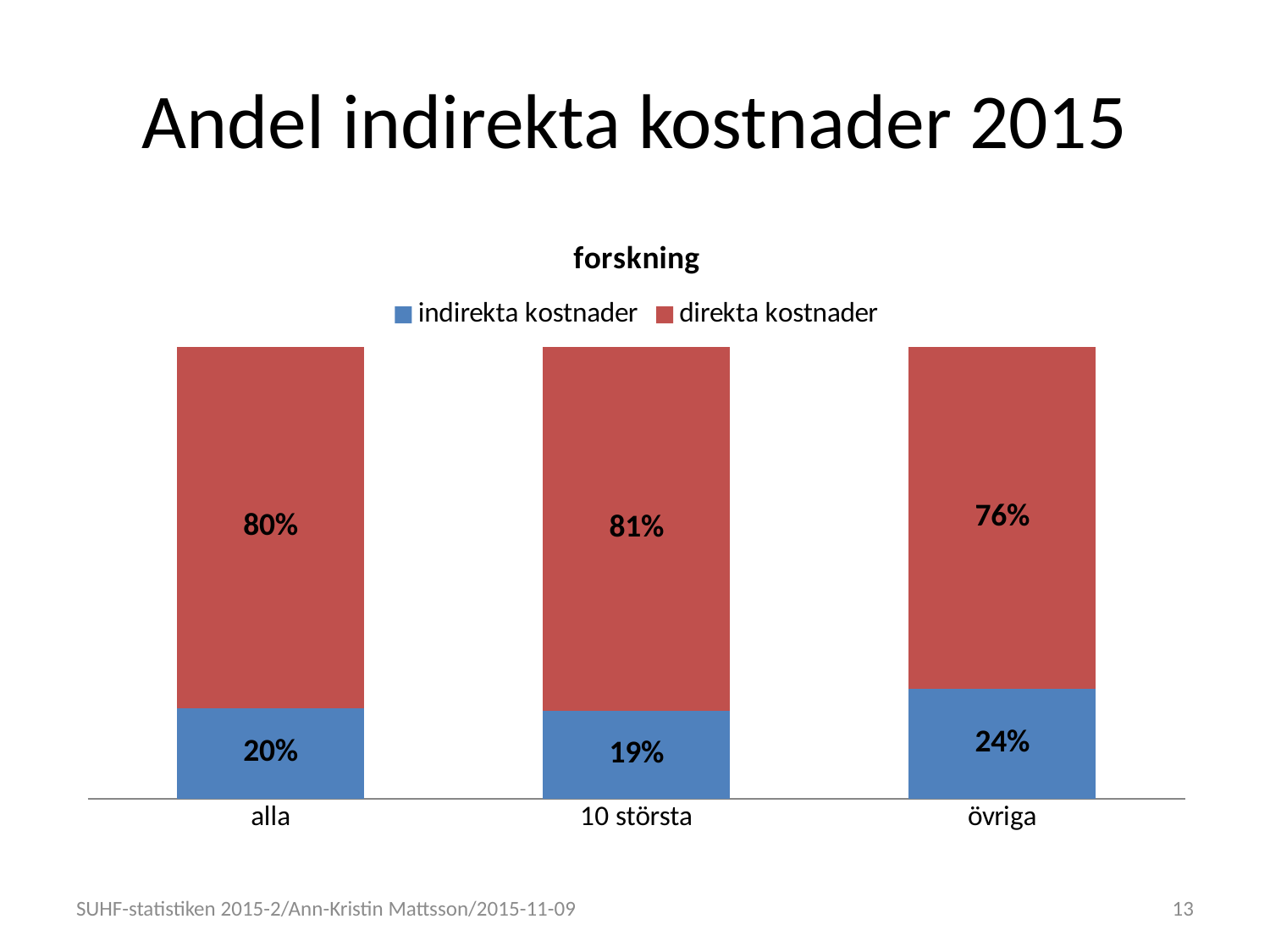
What is the title of the chart? forskning What kind of chart is shown? stacked bar chart What is the value of direkta kostnader for övriga? 76% Which category has the lowest share of indirekta kostnader? 10 största Which category has the highest share of indirekta kostnader? övriga What is the difference between the indirekta kostnader share for övriga and for 10 största? 5% How many series does the legend list? 2 What is the value of direkta kostnader for 10 största? 81% How many categories are shown on the x axis? 3 Which is larger: direkta kostnader for alla or direkta kostnader for övriga? direkta kostnader for alla What is the value of indirekta kostnader for alla? 20% What is the value of indirekta kostnader for övriga? 24%